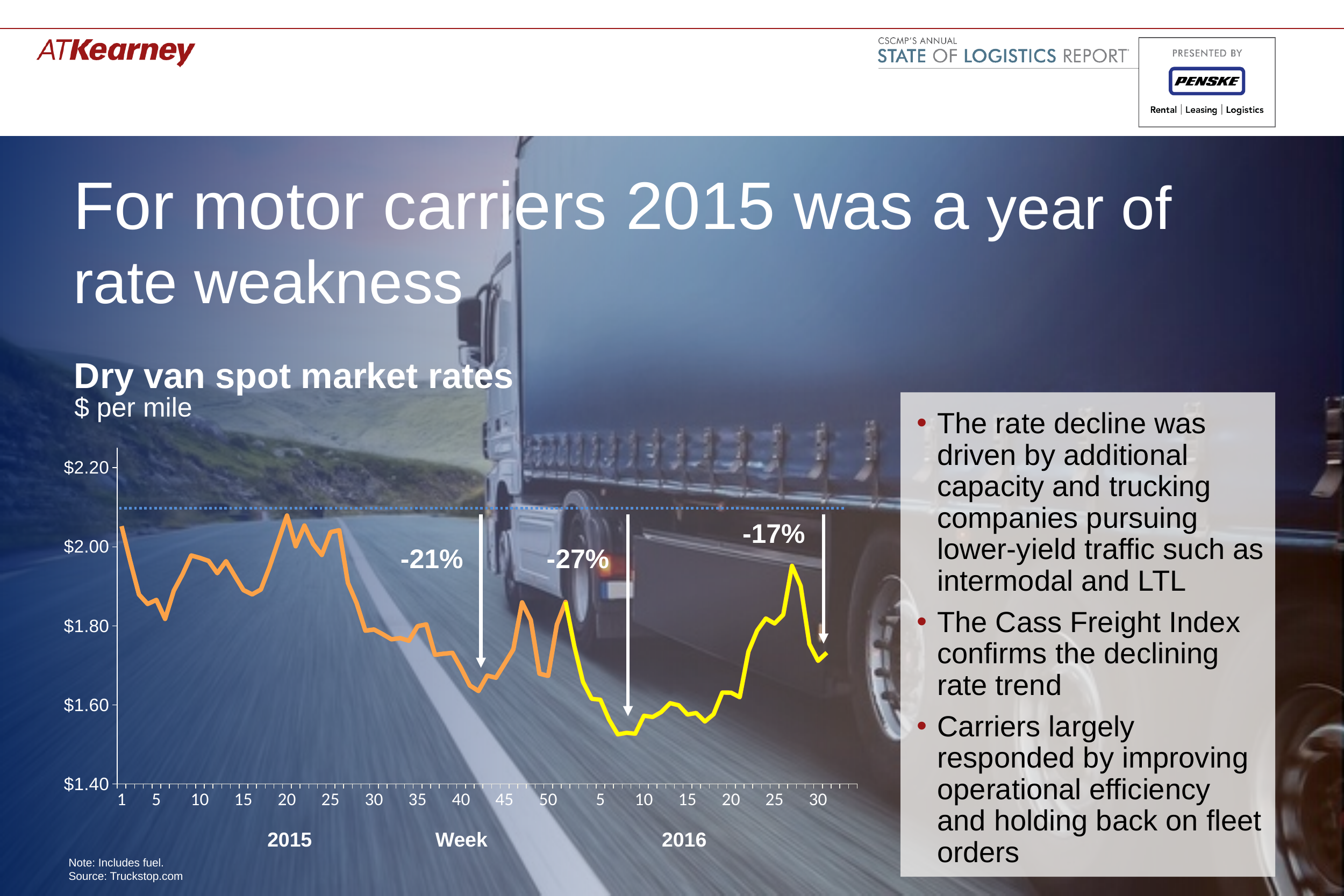
Does the dry van spot rate generally rise or fall over the course of 2015? fall What unit is the chart's y axis measured in? $ per mile What kind of chart is shown on the slide? line chart What percentage decline is annotated at around week 8 of 2016? -27% What percentage decline is annotated at around week 30 of 2016? -17% In which year does the line reach its lowest point on the chart? 2016 What percentage decline is annotated at around week 42 of 2015? -21% What is the title of the chart? Dry van spot market rates Which is higher, the dry van spot rate at week 1 of 2015 or at week 1 of 2016? week 1 of 2015 Is the dry van spot rate at week 1 of 2015 greater or less than $2.00? greater Is the dry van spot rate at its lowest point in 2016 (around week 8) greater or less than $1.60? less Is the dry van spot rate at week 40 of 2015 greater or less than $1.80? less